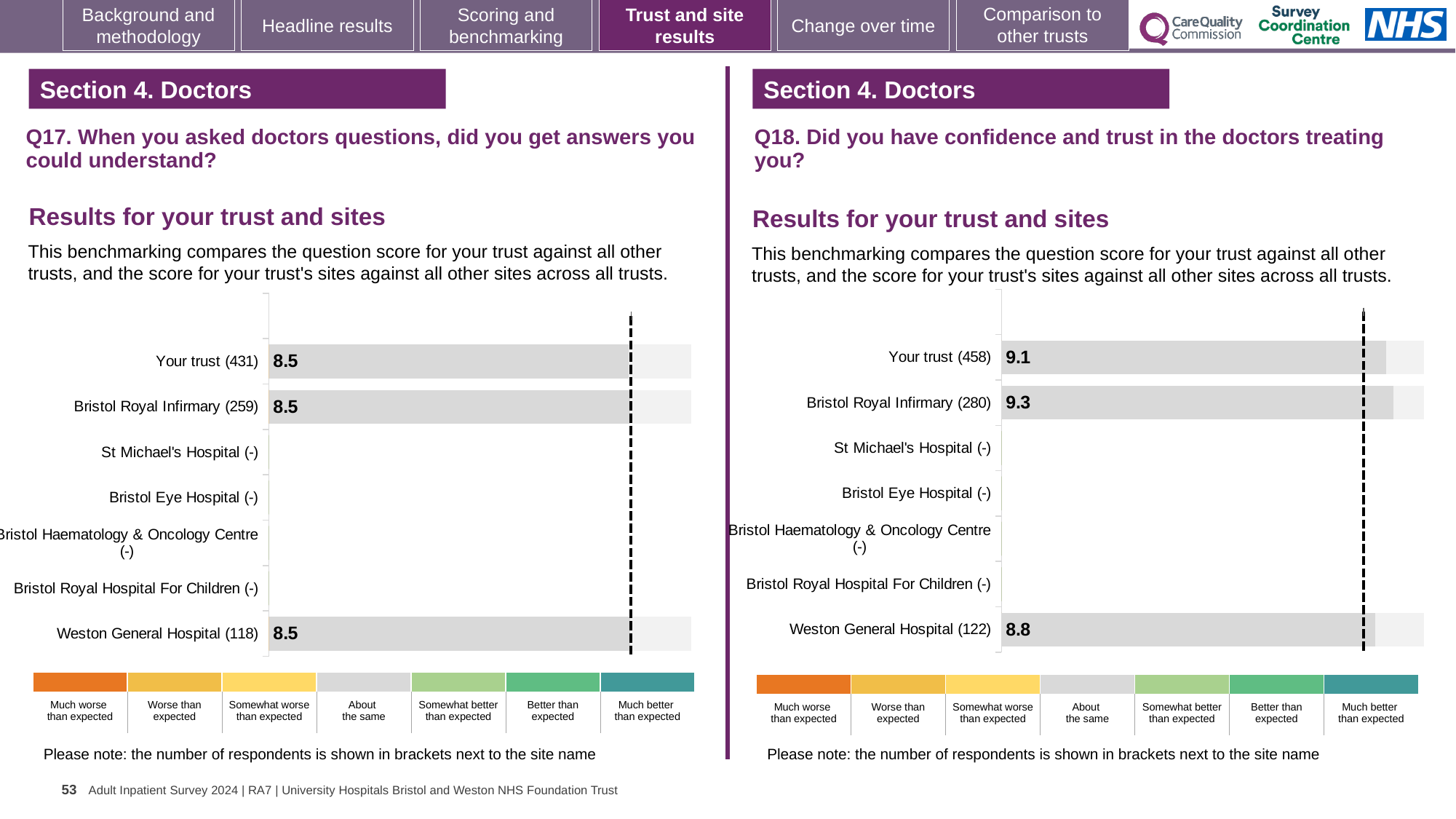
On the Q17 chart (left), what is the score for Your trust? 8.5 On the Q18 chart (right), what is the score for Weston General Hospital? 8.8 On the Q17 chart (left), how many respondents are shown in brackets for Bristol Royal Infirmary? 259 On the Q18 chart (right), what is the score for Bristol Royal Infirmary? 9.3 On the Q17 chart (left), what is the score for Weston General Hospital? 8.5 How many site categories are listed on the Q17 chart (left)? 7 On the Q18 chart (right), what is the score for Your trust? 9.1 On the Q18 chart (right), what is the difference between the scores for Bristol Royal Infirmary and Weston General Hospital? 0.5 On the Q18 chart (right), which is larger: the score for Your trust or the score for Weston General Hospital? Your trust On the Q18 chart (right), which site with a score shown has the lowest score? Weston General Hospital On the Q18 chart (right), which site has the highest score? Bristol Royal Infirmary What kind of chart is used on the Q18 chart (right)? Bar chart